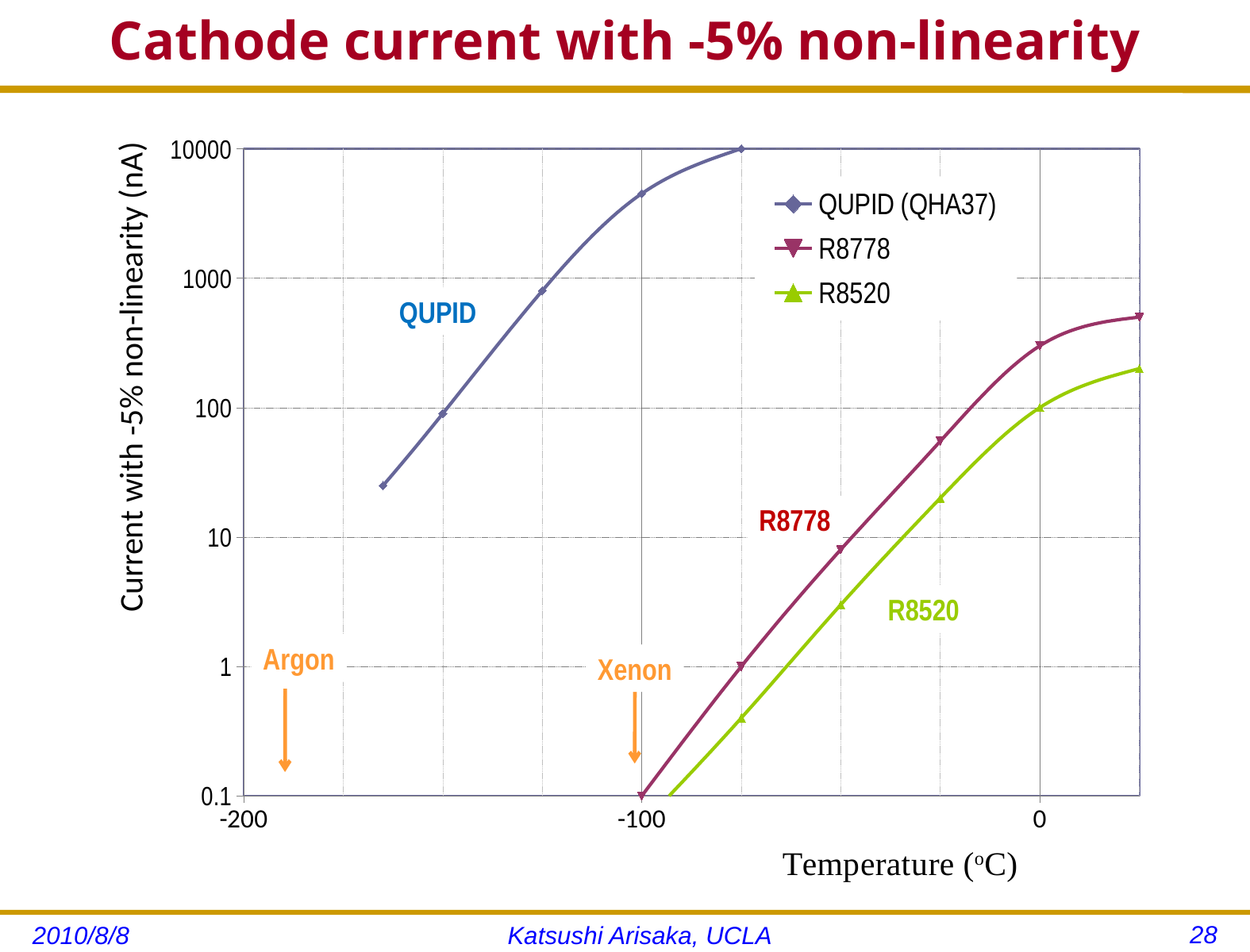
Is the value for QUPID (QHA37) at -100 °C greater or less than 1000? greater Which series has the lowest current at 0 °C? R8520 What are the three series named in the legend? QUPID (QHA37), R8778, R8520 What kind of chart is shown on the slide? line chart Which series has the highest current at -100 °C? QUPID (QHA37) Is the value for R8778 at 0 °C greater or less than 100? greater What is the current with -5% non-linearity for R8778 at -100 °C? 0.1 nA What is the current with -5% non-linearity for R8520 at 0 °C? 100 nA Do the currents rise or fall as temperature increases along the x axis? rise What is the label of the x axis? Temperature (°C) How many series does the legend list? 3 At 0 °C, which series has the larger current, R8778 or R8520? R8778